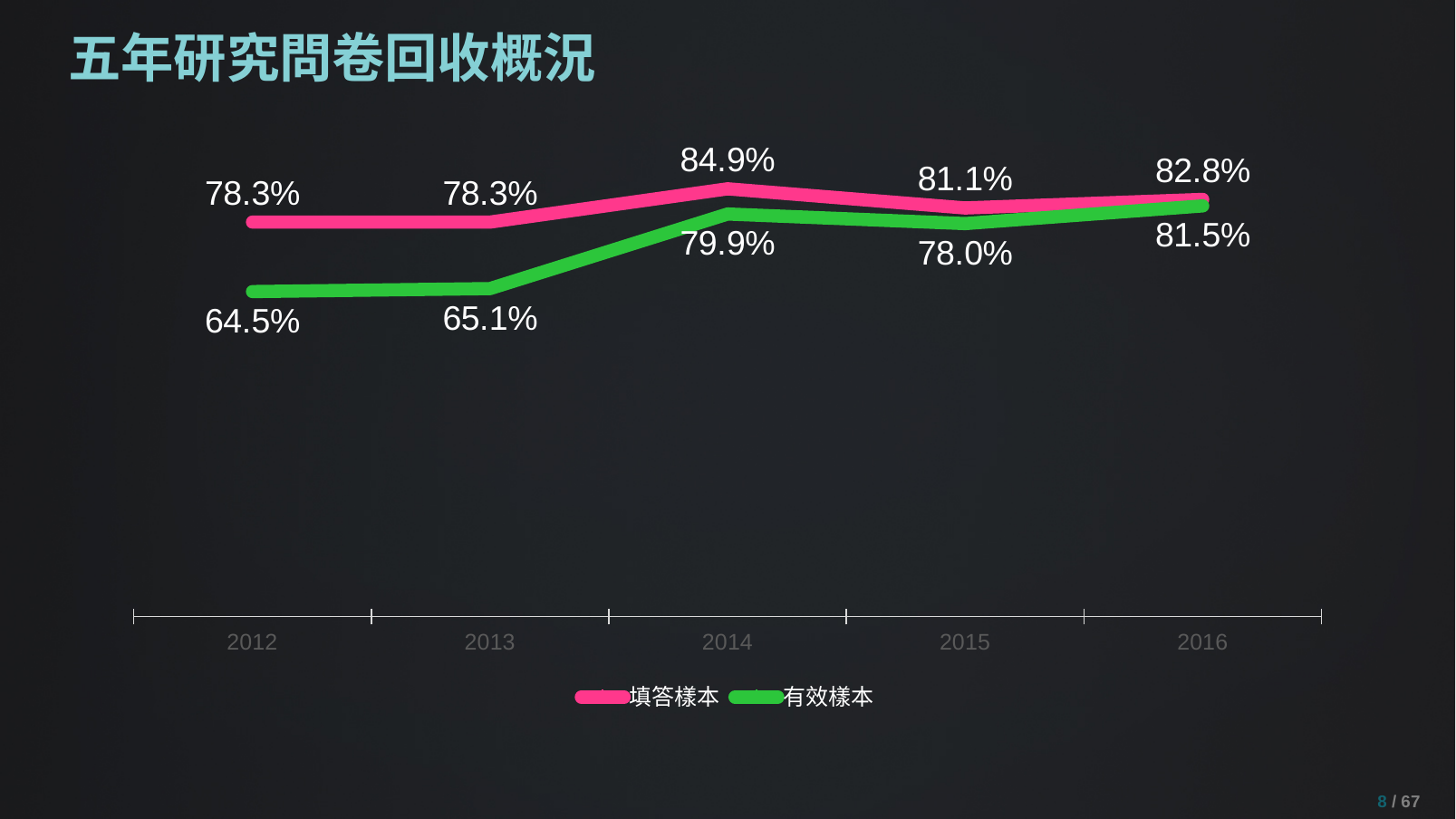
How many years are shown on the x axis? 5 In which year is 填答樣本 highest? 2014 What kind of chart is shown on the slide? line chart What is the difference between 填答樣本 and 有效樣本 in 2012? 13.8% Which is larger in 2013: 填答樣本 or 有效樣本? 填答樣本 What is the difference between 有效樣本 in 2016 and 有效樣本 in 2012? 17.0% What is the value for 有效樣本 in 2016? 81.5% How many series does the legend list? 2 In which year is 有效樣本 lowest? 2012 What is the value for 有效樣本 in 2012? 64.5% What is the value for 填答樣本 in 2014? 84.9% What is the value for 填答樣本 in 2015? 81.1%